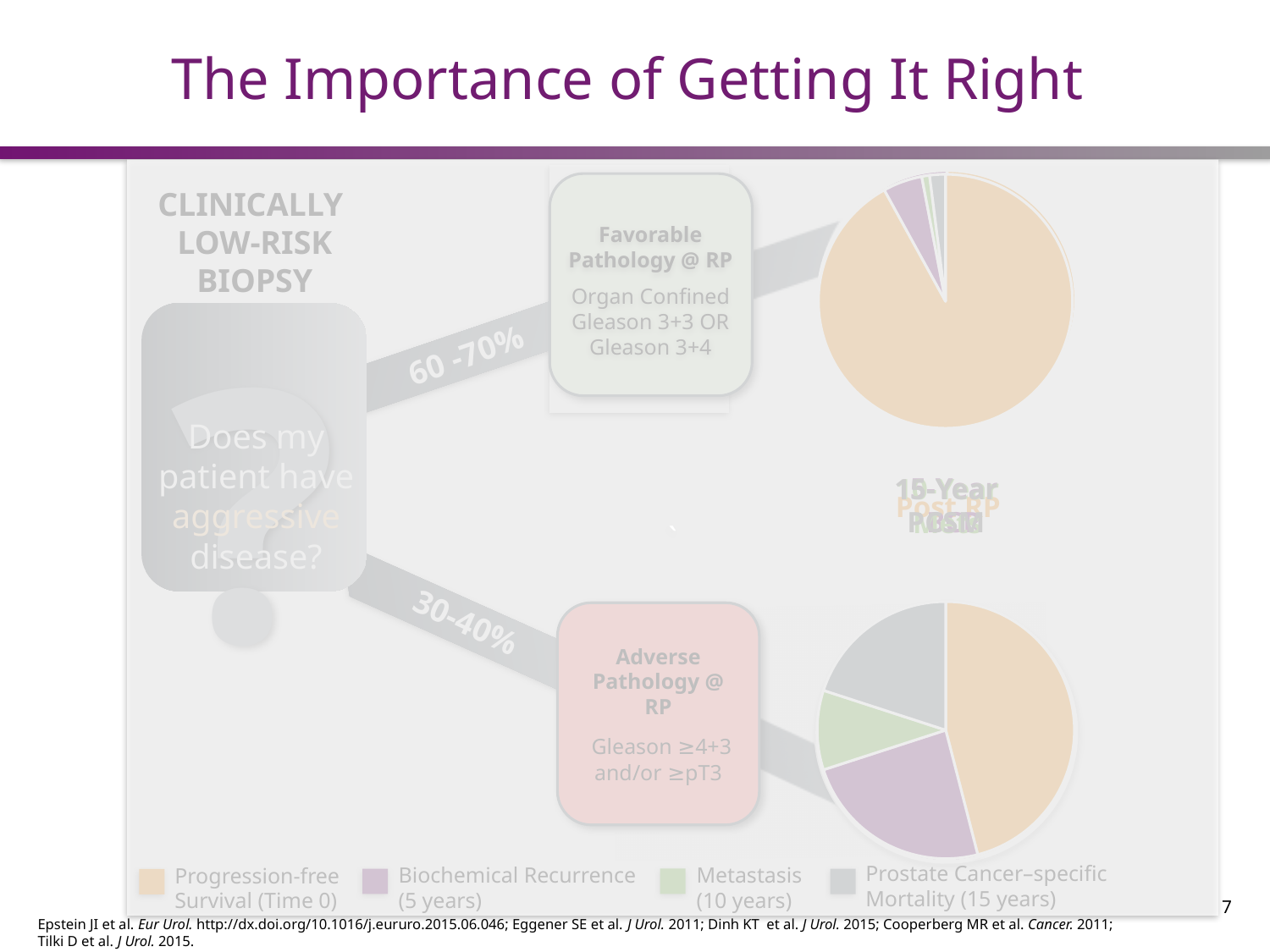
In the lower pie chart (next to Adverse Pathology @ RP), which category has the smallest slice? Metastasis (10 years) What kind of chart is the upper chart on the right side of the slide? Pie chart In the lower pie chart, which slice is larger: Biochemical Recurrence (5 years) or Metastasis (10 years)? Biochemical Recurrence (5 years) In the upper pie chart (next to Favorable Pathology @ RP), which category has the smallest slice? Metastasis (10 years) How many slices does the lower pie chart have? 4 In the upper pie chart, which slice is larger: Progression-free Survival (Time 0) or Biochemical Recurrence (5 years)? Progression-free Survival (Time 0) In the upper pie chart (next to Favorable Pathology @ RP), which category has the largest slice? Progression-free Survival (Time 0) What kind of chart is the lower chart on the right side of the slide? Pie chart In the lower pie chart, which slice is larger: Prostate Cancer–specific Mortality (15 years) or Metastasis (10 years)? Prostate Cancer–specific Mortality (15 years) In the lower pie chart (next to Adverse Pathology @ RP), which category has the largest slice? Progression-free Survival (Time 0) How many entries does the legend at the bottom of the slide list? 4 Which legend entry is shown in green? Metastasis (10 years)